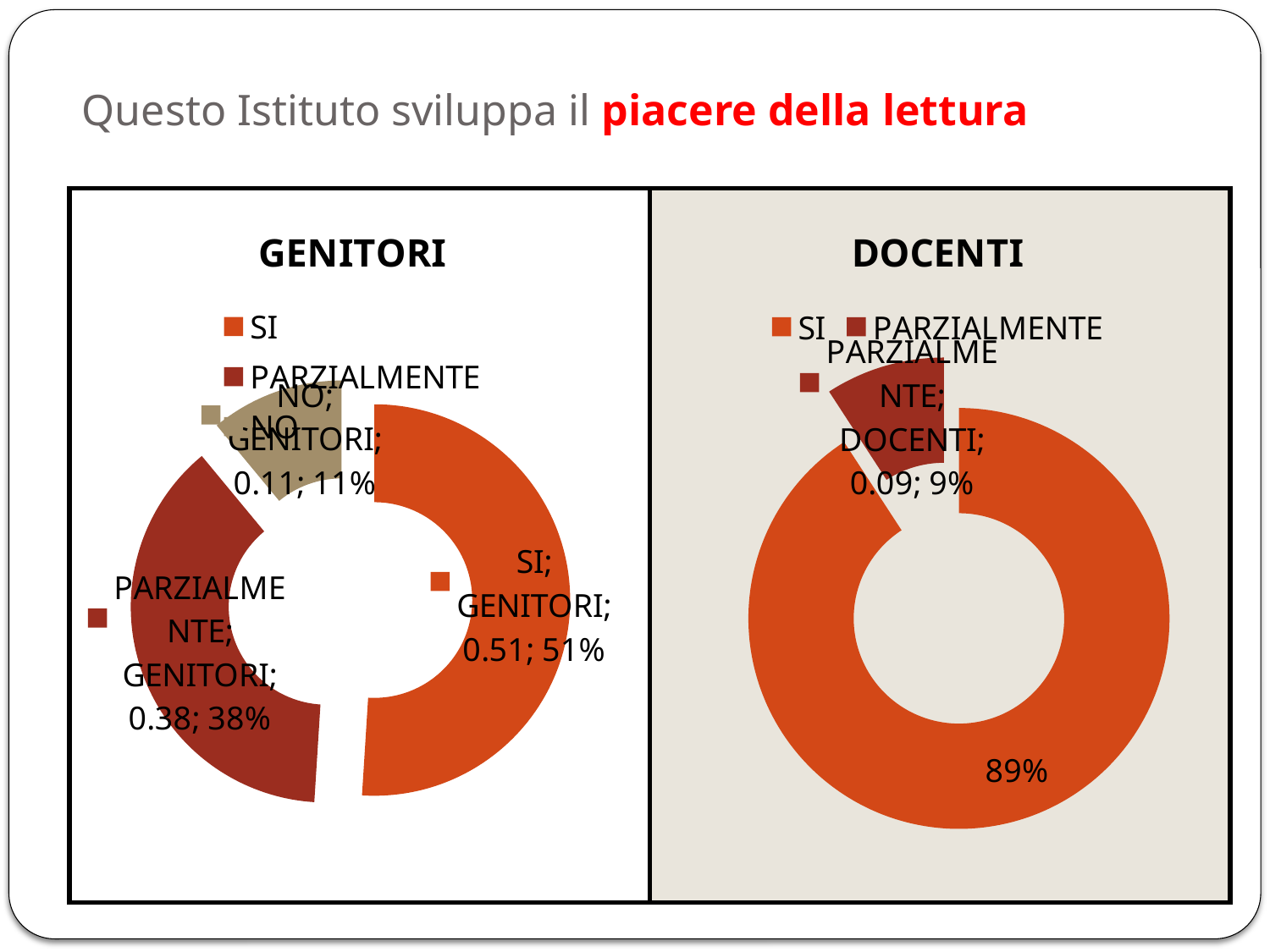
In the GENITORI chart, which category has the largest share? SI Which is larger: the SI share in the GENITORI chart or the SI share in the DOCENTI chart? DOCENTI In the GENITORI chart, what is the difference in percentage points between SI and PARZIALMENTE? 13 In the DOCENTI chart, what percentage is shown for SI? 89% In the DOCENTI chart, which category has the largest share? SI What kind of chart is the GENITORI chart? doughnut chart In the DOCENTI chart, what percentage is shown for PARZIALMENTE? 9% In the GENITORI chart, what percentage is shown for SI? 51% In the GENITORI chart, which category has the smallest share? NO In the GENITORI chart, what percentage is shown for PARZIALMENTE? 38% How many categories are shown in the GENITORI chart? 3 In the GENITORI chart, what percentage is shown for NO? 11%